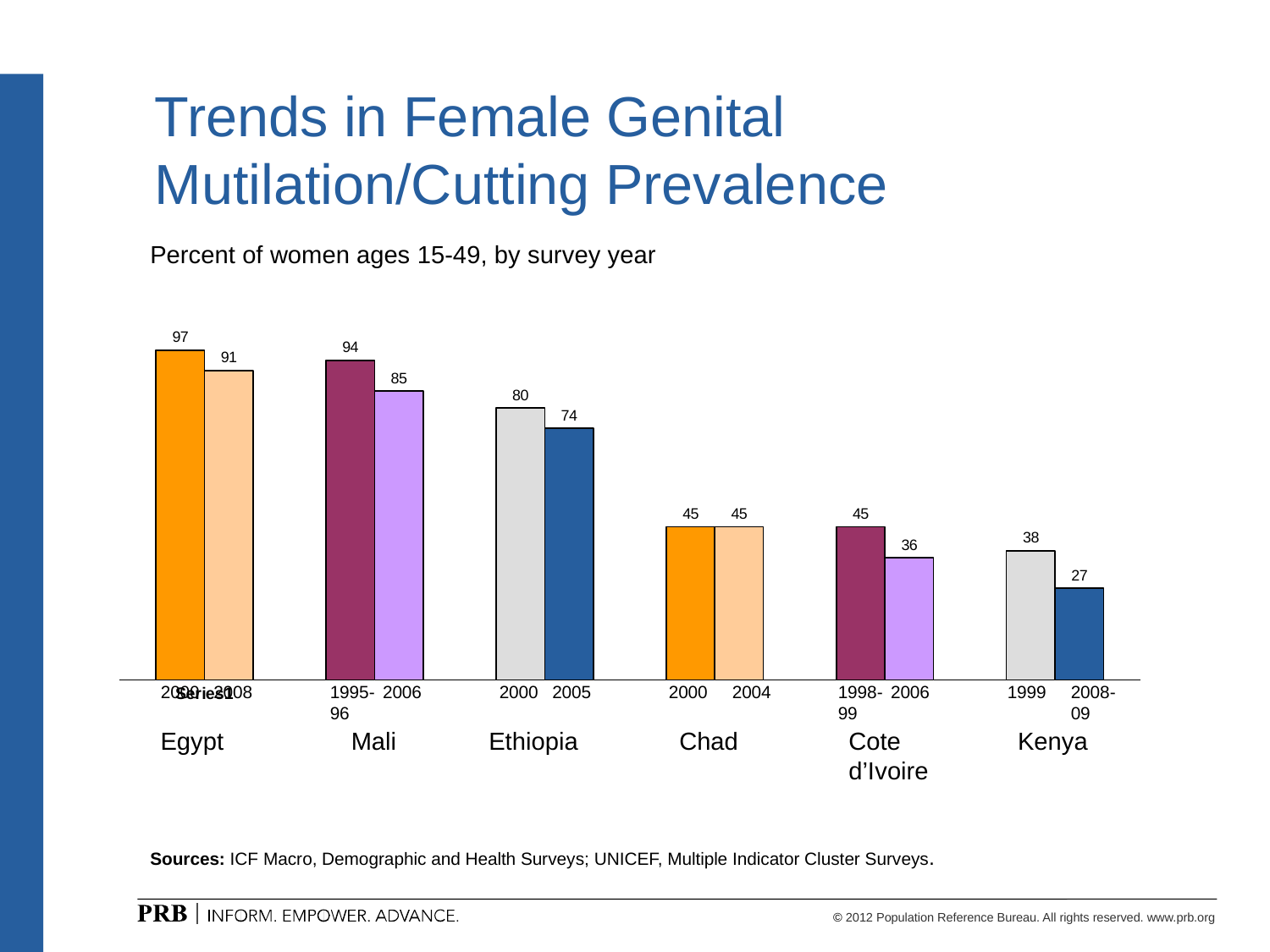
What is the value for Cote d'Ivoire in 1998-99? 45 What is the value for Ethiopia in 2000? 80 What is the difference between Egypt's two values, 97 and 91? 6 What is the FGM/C prevalence for Mali in 2006? 85 Which is larger, Mali's 1995-96 value or Ethiopia's 2000 value? Mali's 1995-96 value Did Chad's value change between 2000 and 2004? No, it stayed at 45 How many countries are shown on the chart? 6 What kind of chart is shown on the slide? bar chart What is the value for Kenya in 2008-09? 27 By how much did Cote d'Ivoire's value fall from 1998-99 to 2006? 9 Which country has the highest bar on the chart? Egypt Which country has the lowest bar on the chart? Kenya